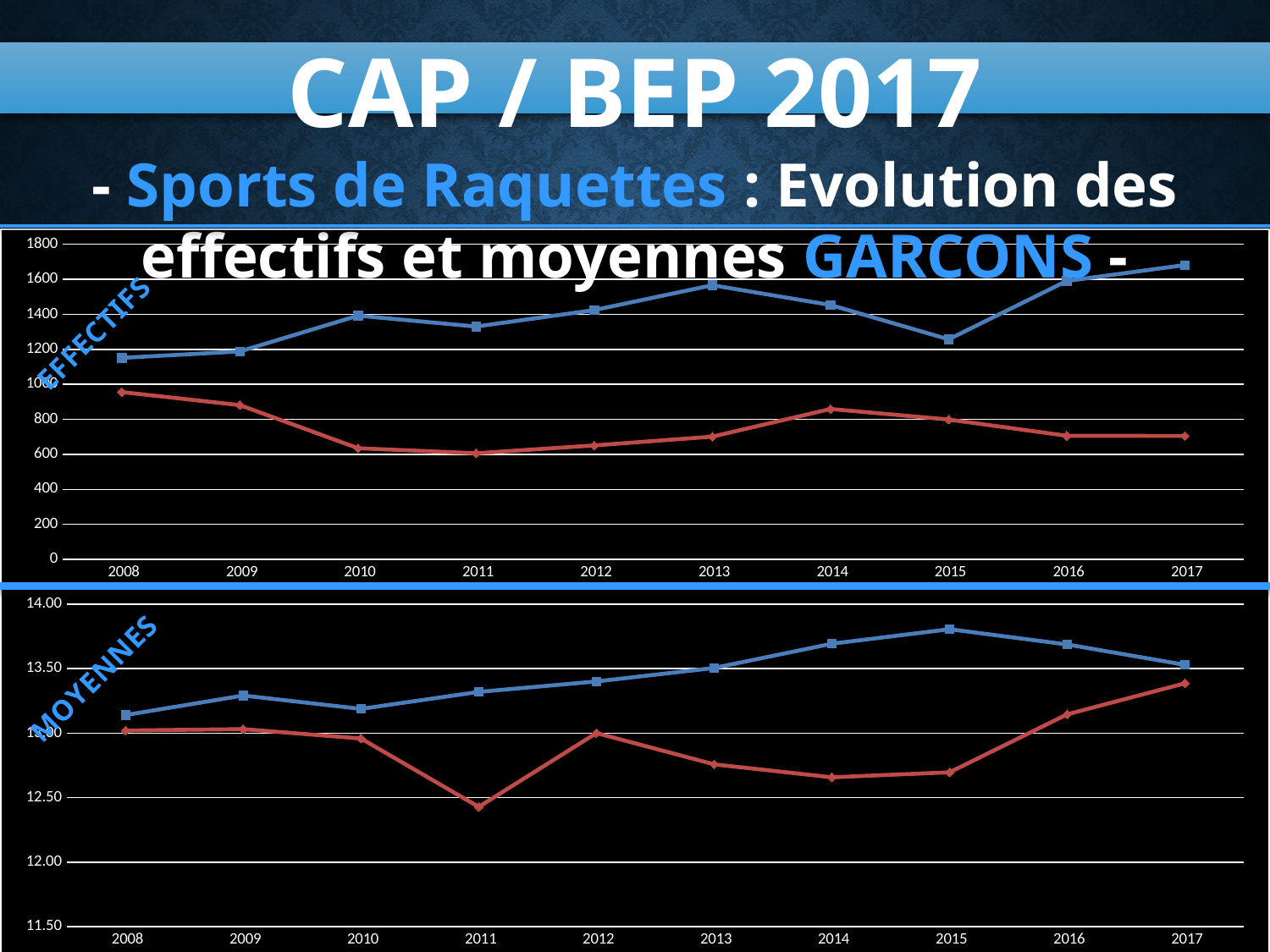
In the bottom chart labelled MOYENNES, does the red line rise or fall from 2015 to 2017? rise How many years are shown on the x axis of the top chart labelled EFFECTIFS? 10 In the top chart labelled EFFECTIFS, is the value of the blue line for 2017 greater or less than 1600? greater What kind of chart is the top chart labelled EFFECTIFS? line chart In the bottom chart labelled MOYENNES, is the value of the blue line for 2015 greater or less than 13.50? greater What kind of chart is the bottom chart labelled MOYENNES? line chart In the top chart labelled EFFECTIFS, is the value of the red line for 2011 greater or less than 800? less In the bottom chart labelled MOYENNES, which year has the lowest value on the red line? 2011 In the top chart labelled EFFECTIFS, which year has the lowest value on the red line? 2011 In the top chart labelled EFFECTIFS, which year has the highest value on the blue line? 2017 In the top chart labelled EFFECTIFS, which line is higher in 2015, the blue line or the red line? the blue line